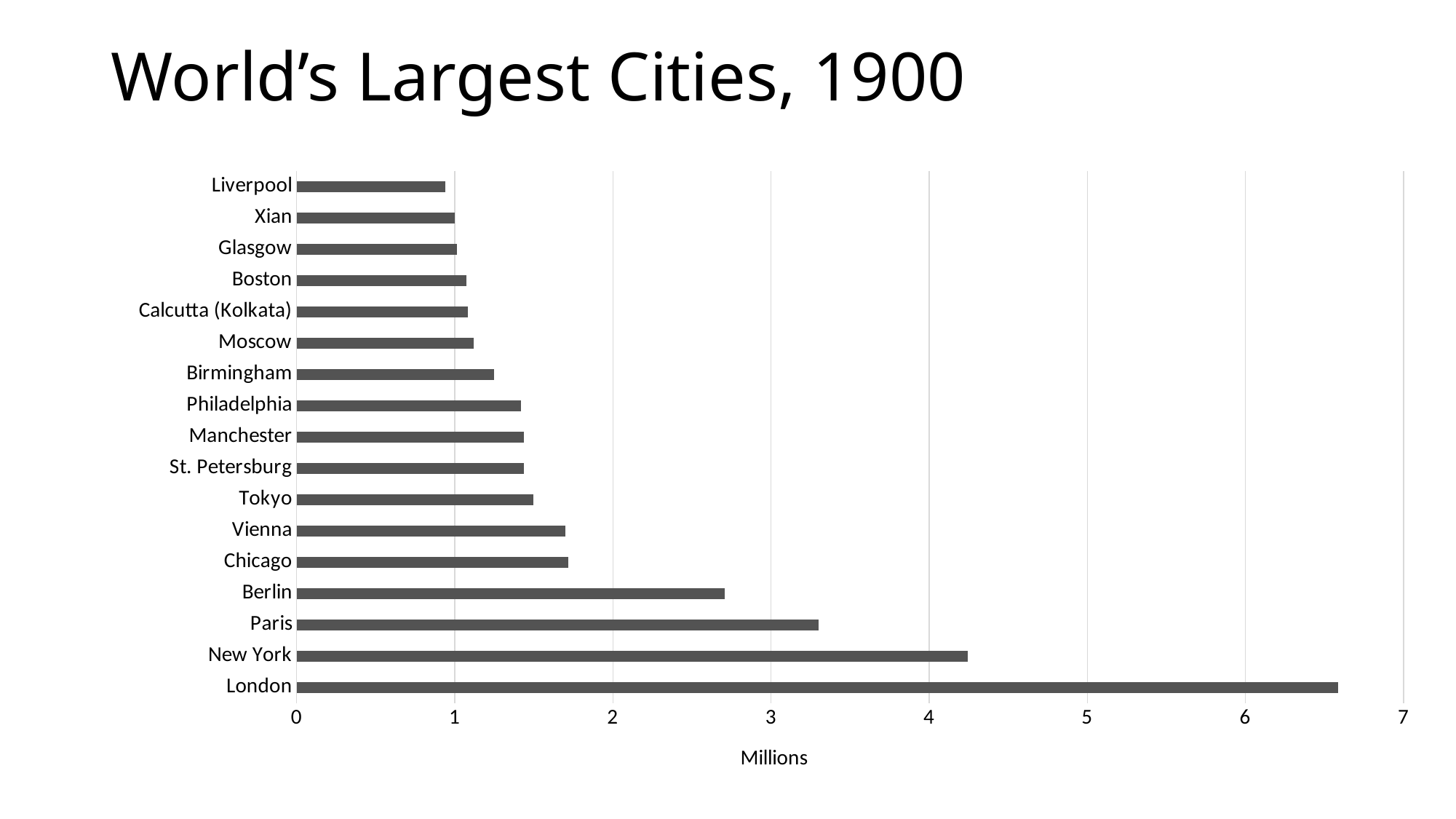
Is the value for Liverpool greater or less than 1? less Is the value for New York greater or less than 4? greater Is the value for Berlin greater or less than 3? less What unit label is shown on the horizontal axis? Millions Which has the larger value, Berlin or Chicago? Berlin How many cities are plotted in the chart? 17 Which city has the smallest population in the chart? Liverpool What kind of chart is shown on the slide? bar chart Which has the larger value, Paris or New York? New York Which city has the largest population in the chart? London